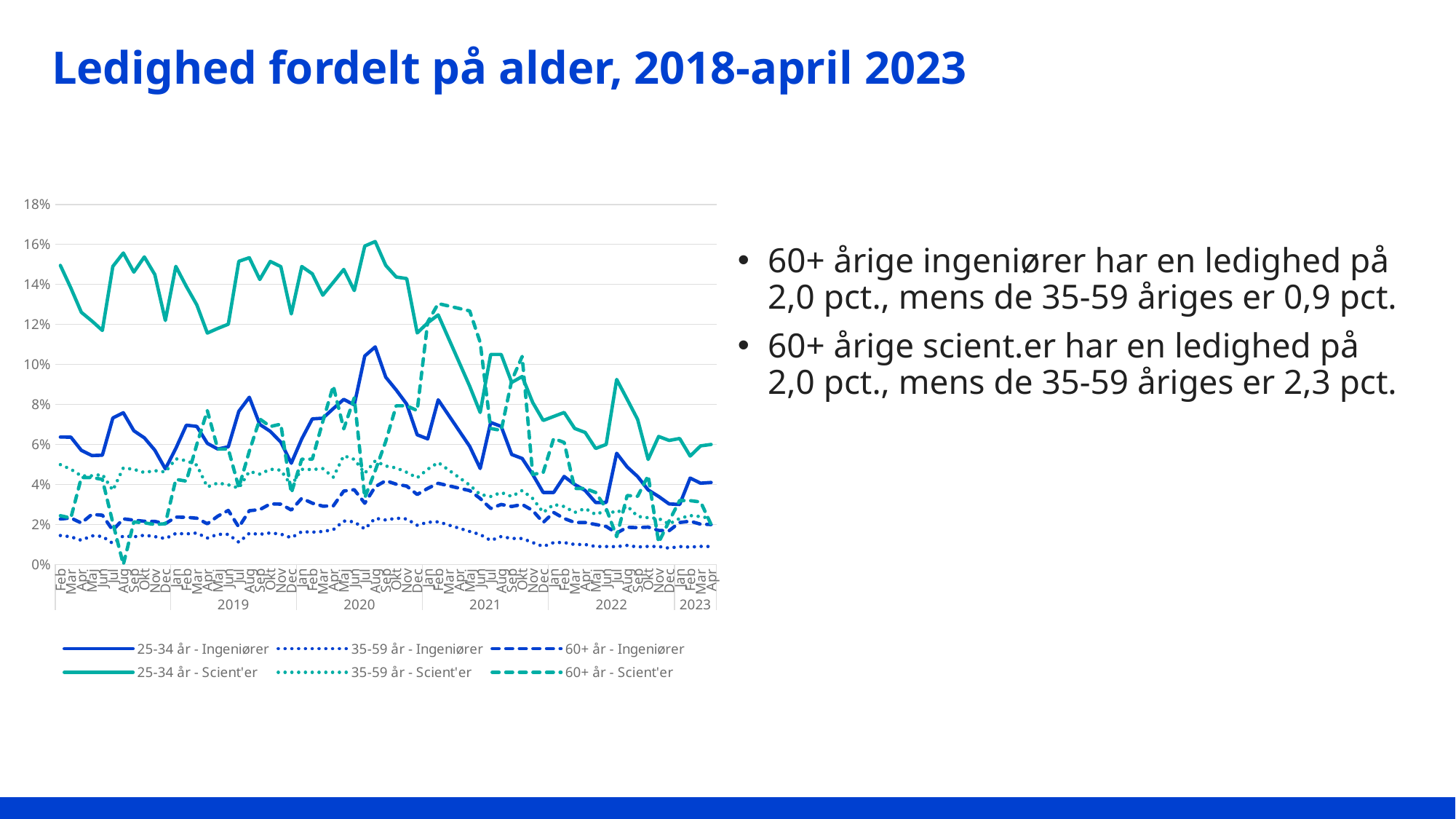
According to the slide text, what is the unemployment rate for 60+ årige ingeniører? 2,0 pct. What is the highest value shown on the chart's vertical axis? 18% Does the 25-34 år - Scient'er series rise or fall overall from 2018 to April 2023? fall Which series stays lowest across the chart? 35-59 år - Ingeniører Which series reaches the highest values on the chart? 25-34 år - Scient'er What kind of chart is shown on the slide? line chart According to the slide text, what is the unemployment rate for 35-59 årige scient'er? 2,3 pct. Is the peak value of the 25-34 år - Scient'er series in 2020 greater or less than 14%? greater Is the 35-59 år - Ingeniører series ever greater or less than 4% over the whole period? less How many series does the chart legend list? 6 At the end of the period (April 2023), which is larger: 25-34 år - Scient'er or 25-34 år - Ingeniører? 25-34 år - Scient'er Is the peak value of the 25-34 år - Ingeniører series in 2020 greater or less than 10%? greater